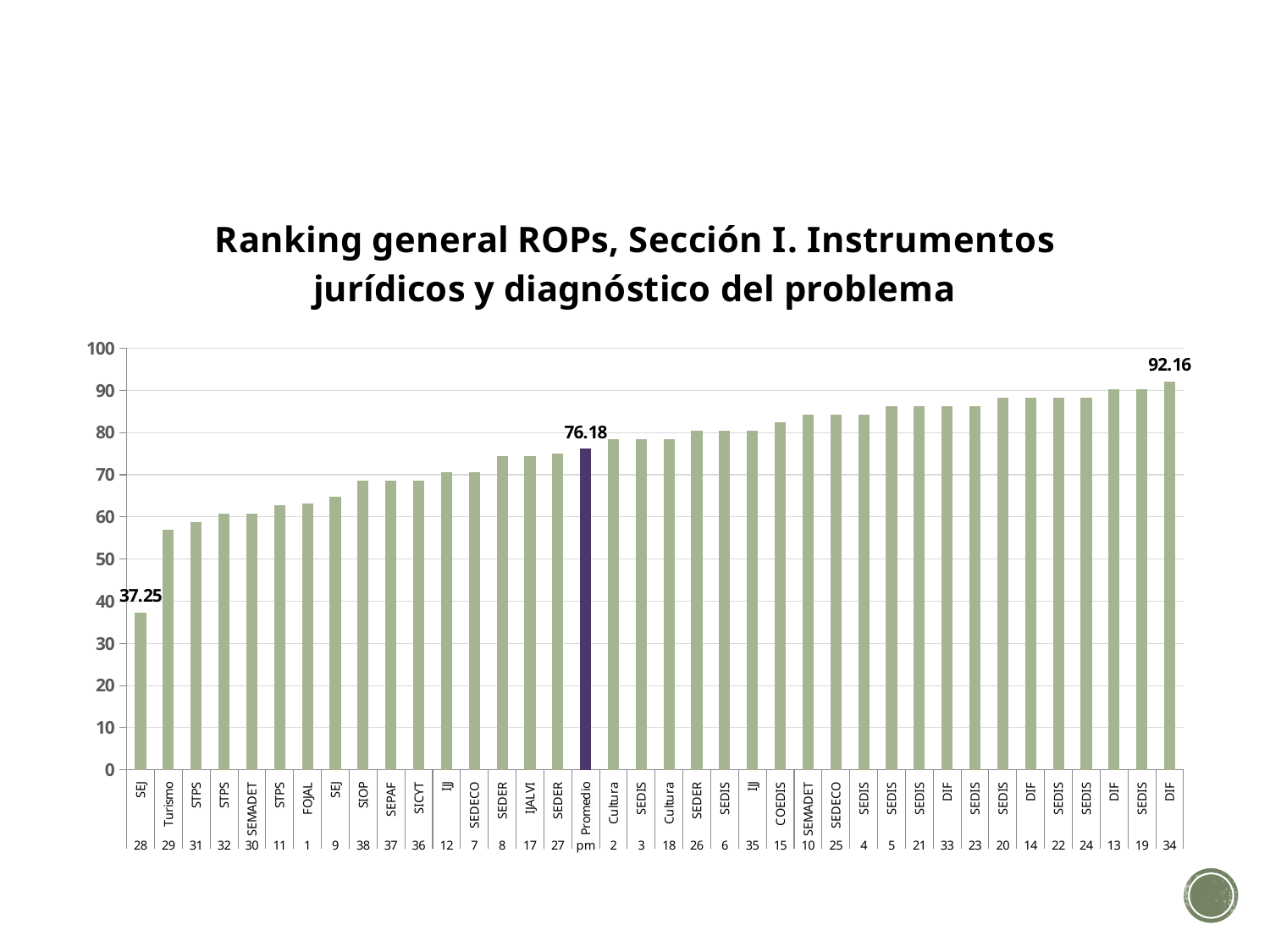
Which category has the highest value? DIF (34) Which category has the lowest value? SEJ (28) What kind of chart is shown on the slide? bar chart Which is larger, the value for Turismo (29) or the value for SEJ (28)? Turismo (29) How much higher is DIF (34) than the Promedio bar? 25.98 What is the value for SEJ (28), the first bar on the left? 37.25 Is the value for SEMADET (10) greater or less than 80? greater Is the value for Turismo (29) greater or less than 50? greater What is the difference between the highest value (DIF 34) and the lowest value (SEJ 28)? 54.91 What is the value for DIF (34), the last bar on the right? 92.16 What is the value of the Promedio bar? 76.18 Do the values rise or fall from left to right along the x axis? rise